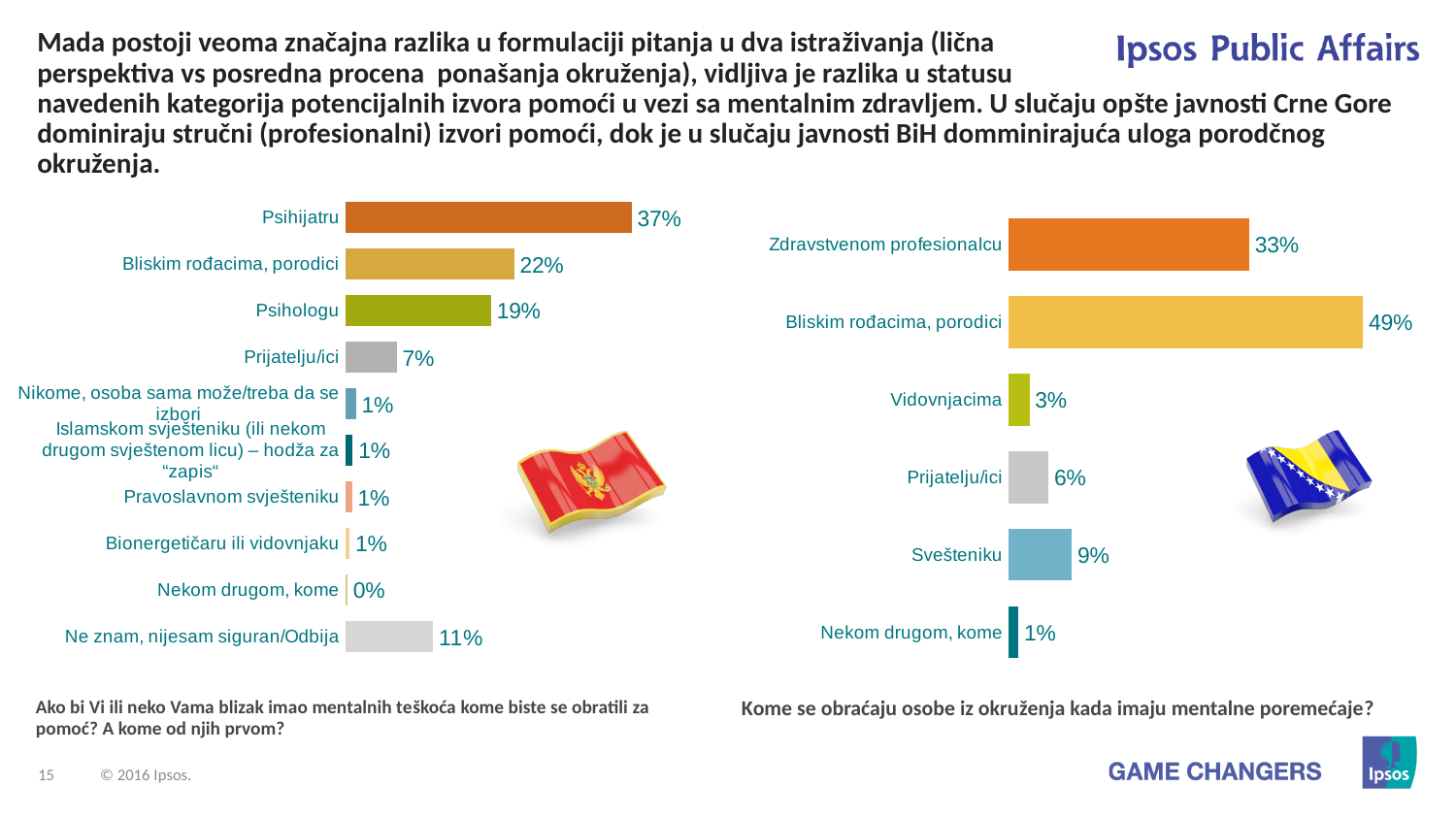
In the right chart, which category has the lowest value? Nekom drugom, kome In the left chart, which category has the highest value? Psihijatru How many categories does the right chart show? 6 In the right chart, what is the value for Svešteniku? 9% Which is larger: Prijatelju/ici in the left chart or Prijatelju/ici in the right chart? Left chart (7%) What type of chart is the left chart? Bar chart In the right chart, what is the difference between Bliskim rođacima, porodici and Zdravstvenom profesionalcu? 16% In the right chart, what is the value for Bliskim rođacima, porodici? 49% In the left chart, what is the value for Psihijatru? 37% In the left chart, which category has the lowest value? Nekom drugom, kome In the left chart, what is the difference between Psihijatru and Psihologu? 18% In the left chart, what is the value for Ne znam, nijesam siguran/Odbija? 11%